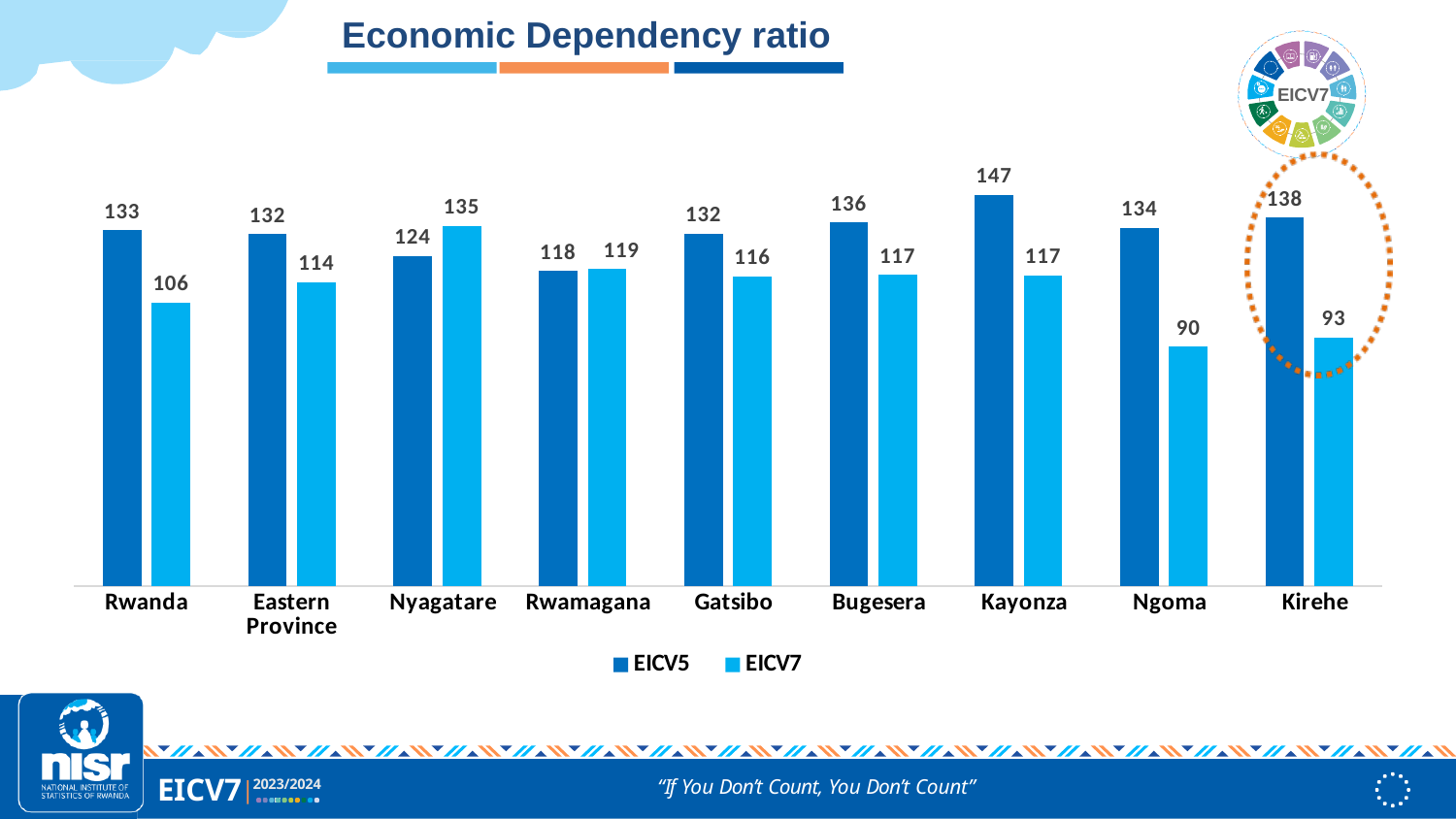
How many series does the legend list? 2 Which category has the lowest EICV7 value? Ngoma What is the EICV7 economic dependency ratio for Ngoma? 90 Which category has the highest EICV5 value? Kayonza What kind of chart is shown on the slide? Bar chart Which is larger for Nyagatare, the EICV5 value or the EICV7 value? EICV7 What is the difference between the EICV5 and EICV7 values for Kirehe? 45 How many categories are shown on the x axis? 9 What is the title of the chart? Economic Dependency ratio What is the EICV7 economic dependency ratio for Rwanda? 106 What is the EICV5 economic dependency ratio for Kayonza? 147 Which category is circled with a dotted orange outline on the chart? Kirehe